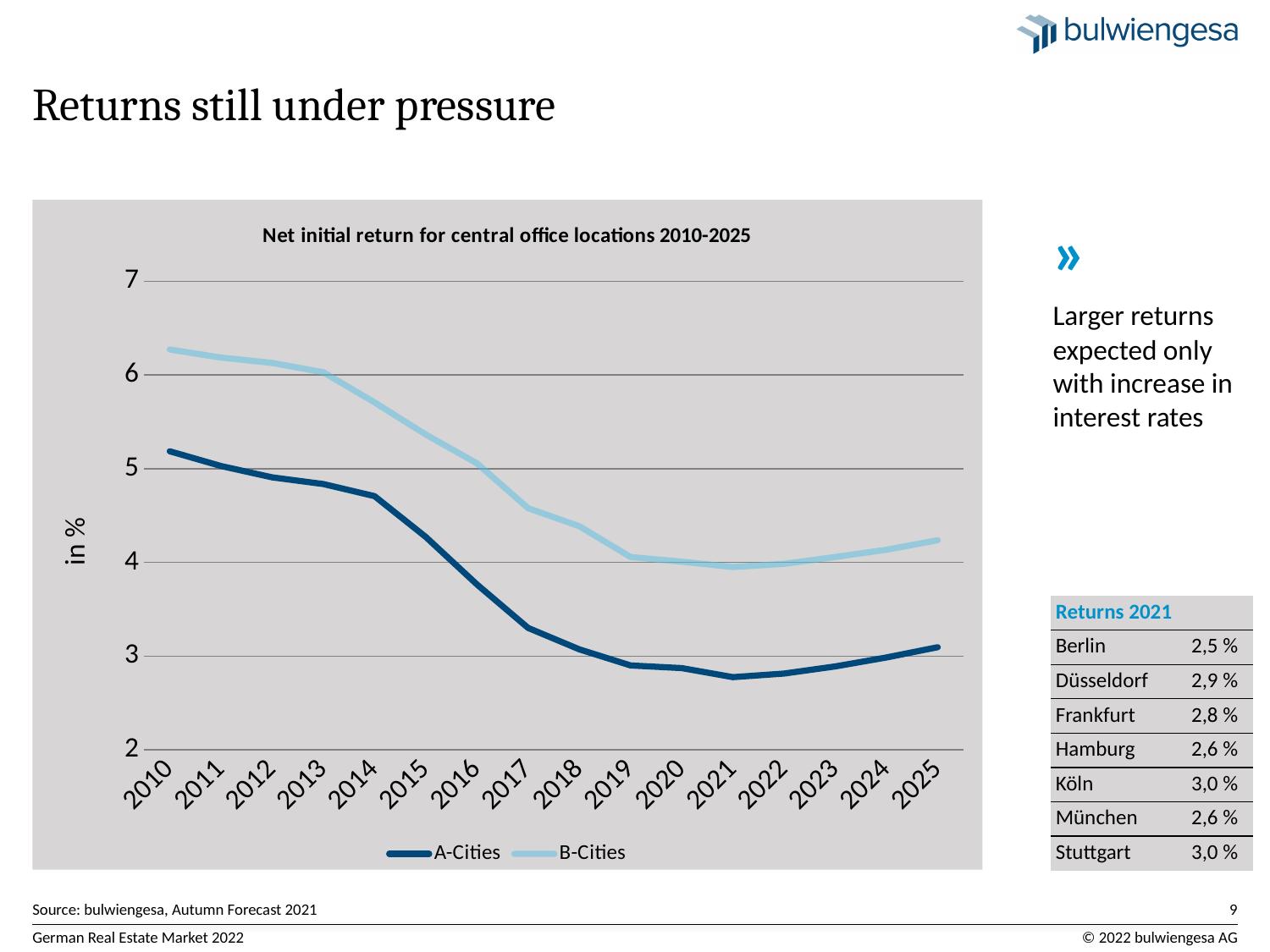
What is the label on the y axis of the chart? in % Is the value for A-Cities in 2021 greater or less than 3? less What kind of chart is shown on the slide? line chart Is the value for B-Cities in 2010 greater or less than 6? greater How many series does the chart legend list? 2 Is the value for B-Cities in 2017 greater or less than 4? greater Do the A-Cities values rise or fall from 2010 to 2021? fall What is the title of the chart? Net initial return for central office locations 2010-2025 How many years are plotted along the x axis of the chart? 16 Which series has the higher value in 2020, A-Cities or B-Cities? B-Cities